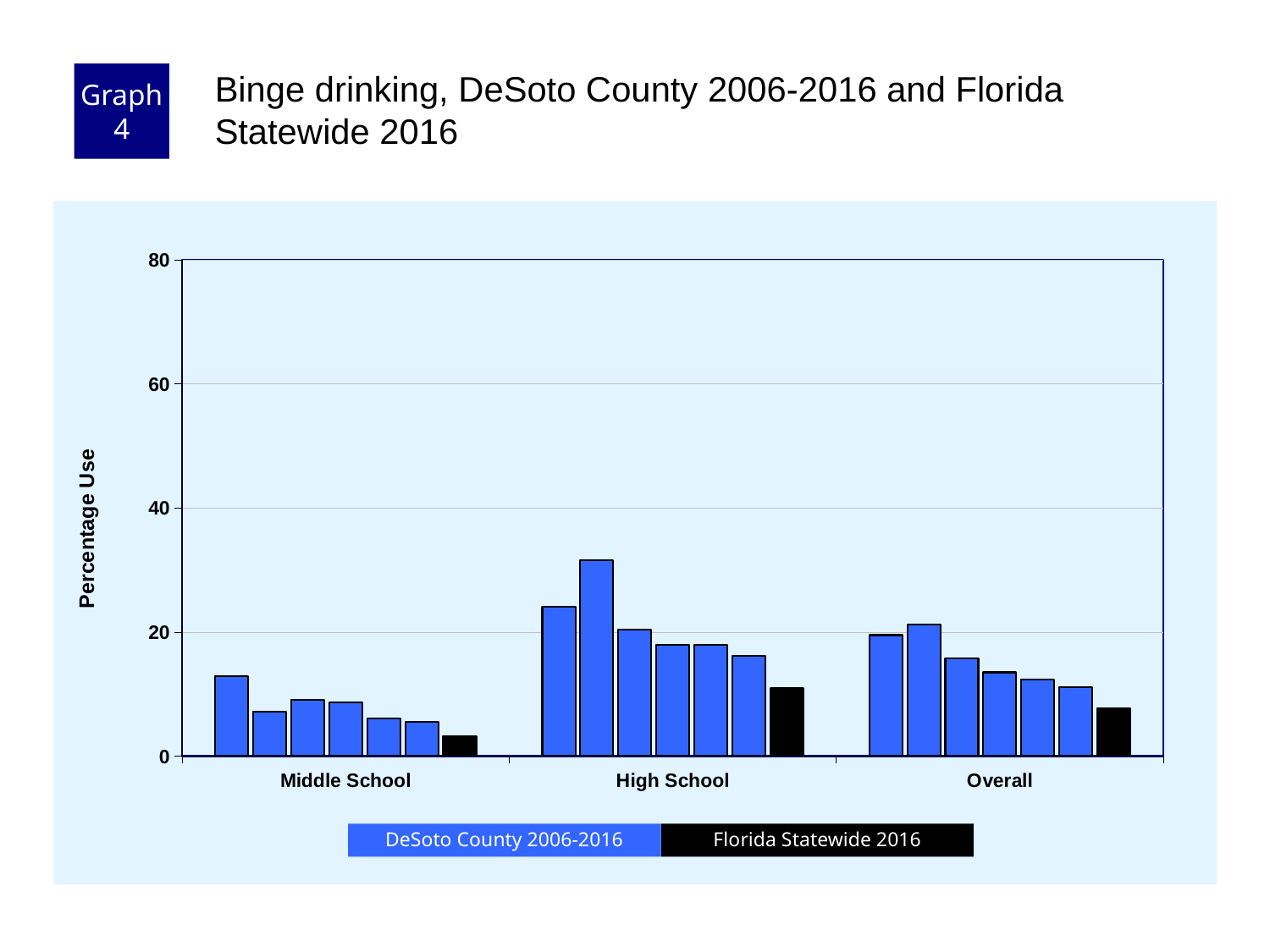
Is the tallest DeSoto County 2006-2016 bar in the High School group greater or less than 20? greater Which is larger, the Florida Statewide 2016 value for High School or for Middle School? High School What colour are the Florida Statewide 2016 bars? black Is the Florida Statewide 2016 value for Middle School greater or less than 20? less How many series does the legend list? 2 Which category has the lowest Florida Statewide 2016 value? Middle School How many categories are shown on the x axis? 3 What is the label on the y axis? Percentage Use What kind of chart is shown on the slide? bar chart Is the tallest DeSoto County 2006-2016 bar in the High School group greater or less than 40? less Which category contains the tallest bar in the chart? High School